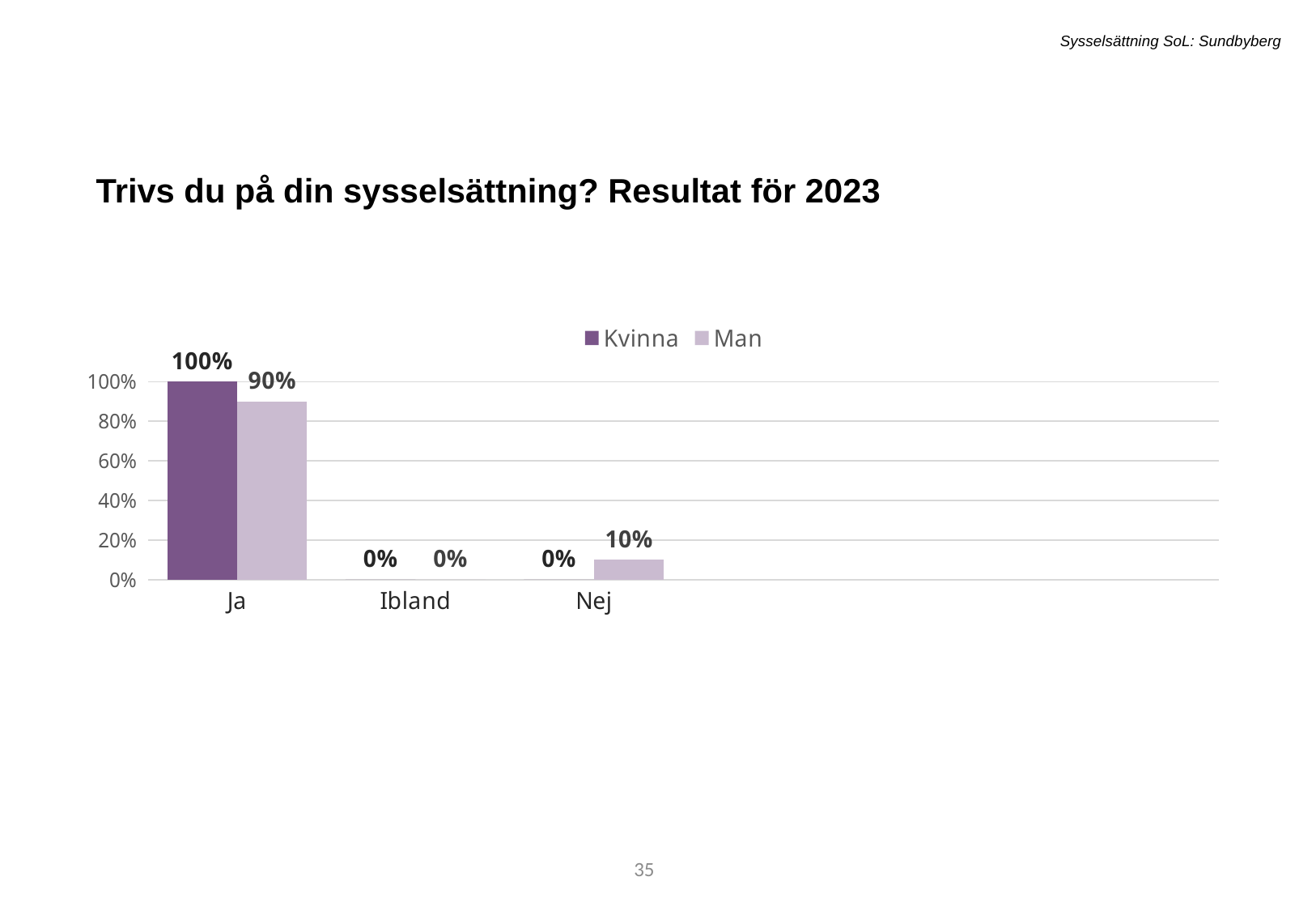
What is the value for Man in the Nej category? 10% What is the value for Man in the Ja category? 90% What kind of chart is shown on the slide? Bar chart What is the title of the slide? Trivs du på din sysselsättning? Resultat för 2023 How many categories are shown on the x axis? 3 What is the difference between the Kvinna and Man values in the Ja category? 10% In the Ja category, which series has the larger value, Kvinna or Man? Kvinna Which category has the highest value for Man? Ja What is the value for Kvinna in the Ja category? 100% How many series does the legend list? 2 What are the two series named in the legend? Kvinna and Man What is the value for Kvinna in the Nej category? 0%